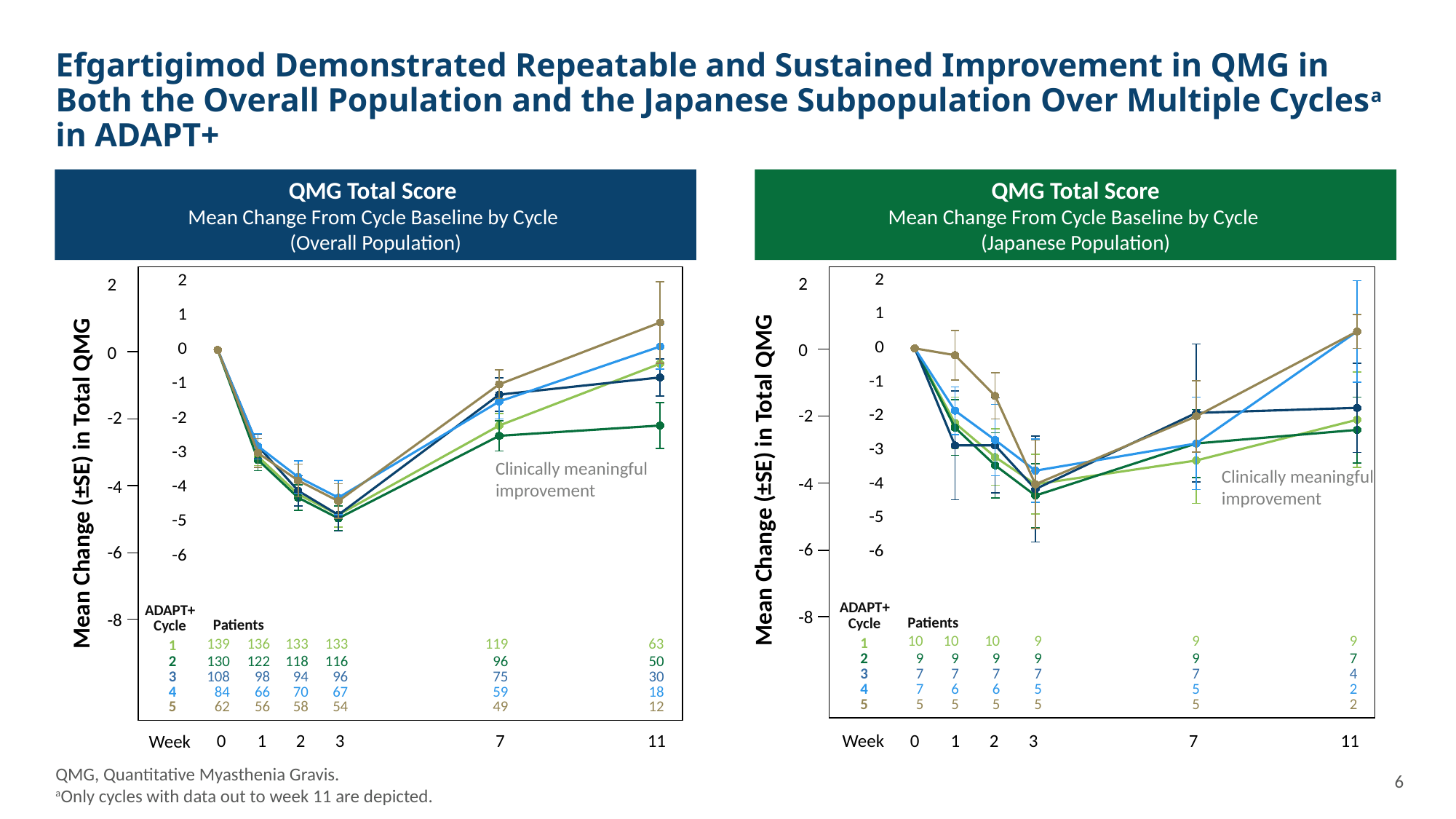
In the Overall Population chart, how many patients were in Cycle 5 at week 11? 12 In the Japanese Population chart, is the mean change for Cycle 3 at week 1 greater or less than -2? less In the Japanese Population chart, how many patients were in Cycle 3 at week 11? 4 In the Overall Population chart, do the mean change values rise or fall from week 0 to week 3? fall What kind of chart is the QMG Total Score (Overall Population) chart? line chart In the Overall Population chart, how many ADAPT+ cycles are plotted? 5 In the Overall Population chart, which cycle has the highest mean change at week 11? Cycle 5 In the Overall Population chart, is the mean change for Cycle 2 at week 3 greater or less than -4? less In the Overall Population chart, how many week time points are shown on the x axis? 6 In the Overall Population chart, how many more patients were in Cycle 1 at week 0 than at week 11? 76 In the Overall Population chart, how many patients were in Cycle 3 at week 7? 75 In the Overall Population chart, how many patients were in Cycle 1 at week 0? 139